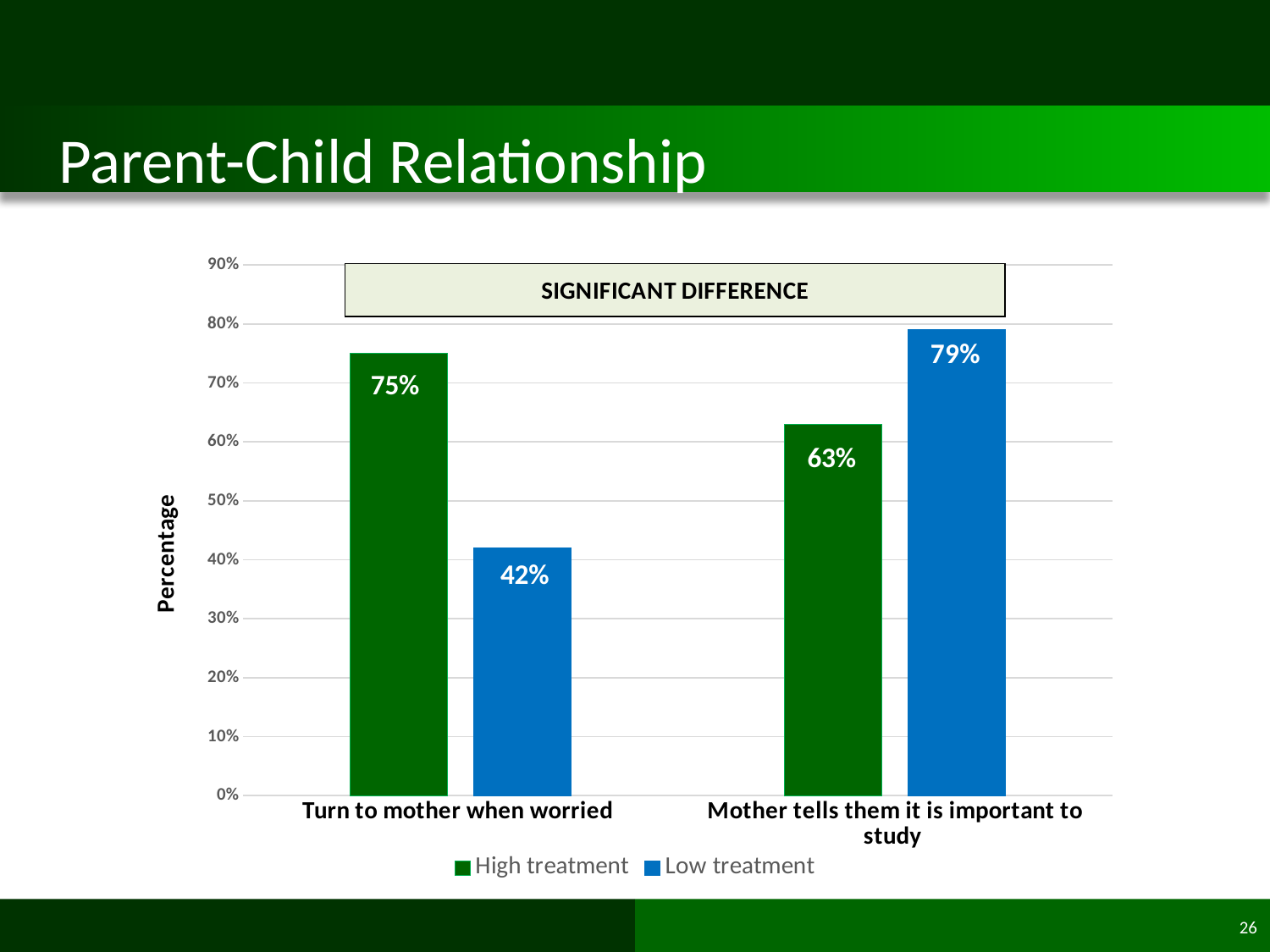
What is the value for Low treatment in the 'Mother tells them it is important to study' category? 79% What is the value for High treatment in the 'Mother tells them it is important to study' category? 63% How many series does the legend list? 2 What is the difference between High treatment and Low treatment for 'Turn to mother when worried'? 33% Which series has the highest value in the 'Mother tells them it is important to study' category? Low treatment How many categories are shown on the x axis? 2 Which bar has the lowest value on the chart? Low treatment, Turn to mother when worried What is the value for Low treatment in the 'Turn to mother when worried' category? 42% What is the value for High treatment in the 'Turn to mother when worried' category? 75% What is the difference between Low treatment and High treatment for 'Mother tells them it is important to study'? 16% Which is larger: High treatment for 'Turn to mother when worried' or High treatment for 'Mother tells them it is important to study'? Turn to mother when worried What kind of chart is shown on the slide? Bar chart